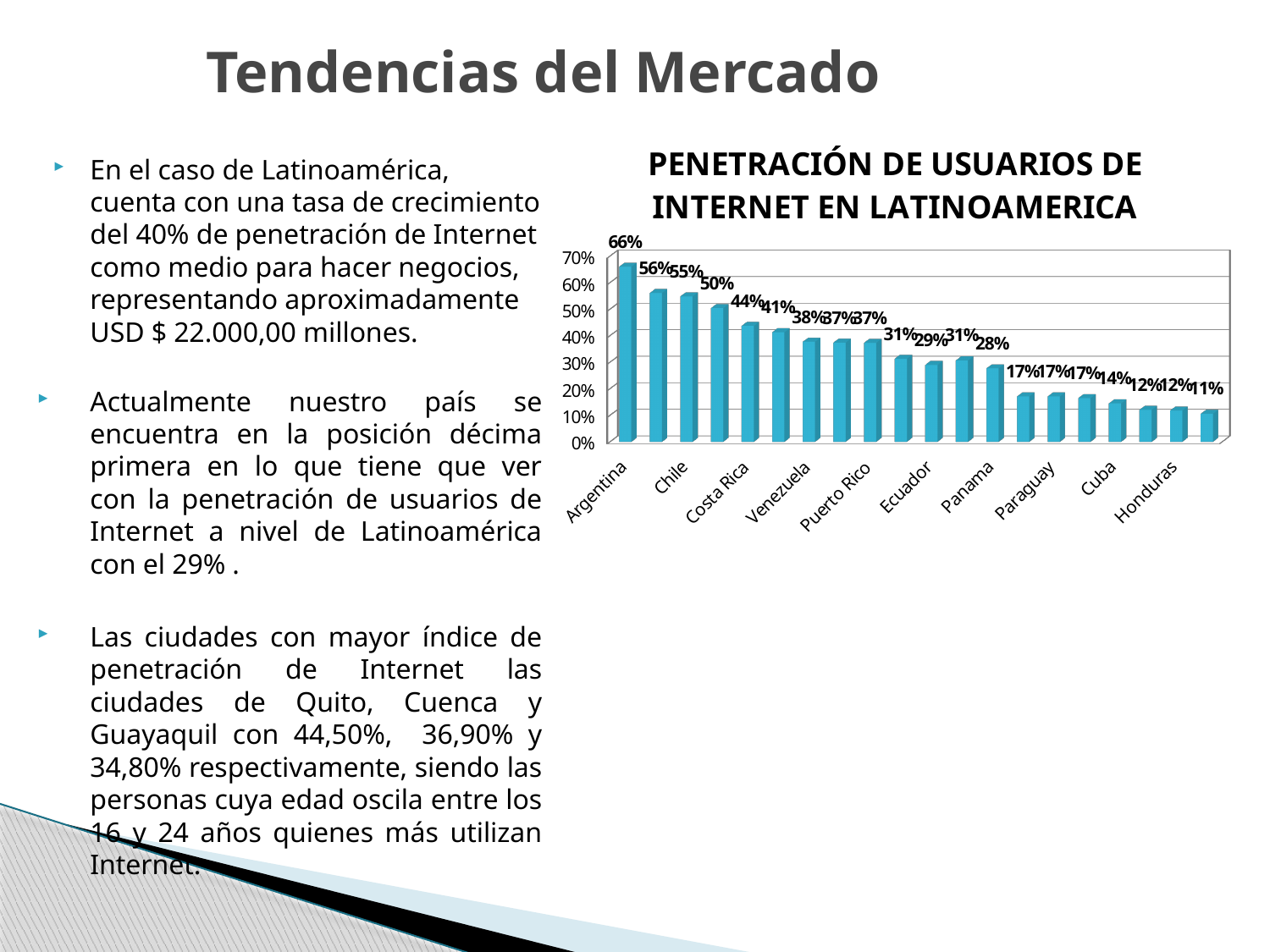
Which has a higher Internet penetration, Chile or Costa Rica? Chile What is the difference in percentage points between Argentina's and Ecuador's Internet penetration? 37 percentage points What is the Internet penetration value shown for Ecuador? 29% Is the value for Cuba greater or less than 20%? less What is the Internet penetration value shown for Argentina? 66% What is the Internet penetration value shown for Honduras? 12% Which country has the highest Internet penetration in the chart? Argentina What type of chart is shown on the slide? Bar chart Is the value for Venezuela greater or less than 30%? greater Do the values rise or fall from left to right along the x axis? Fall How many bars are plotted in the chart? 20 What is the Internet penetration value shown for Chile? 55%